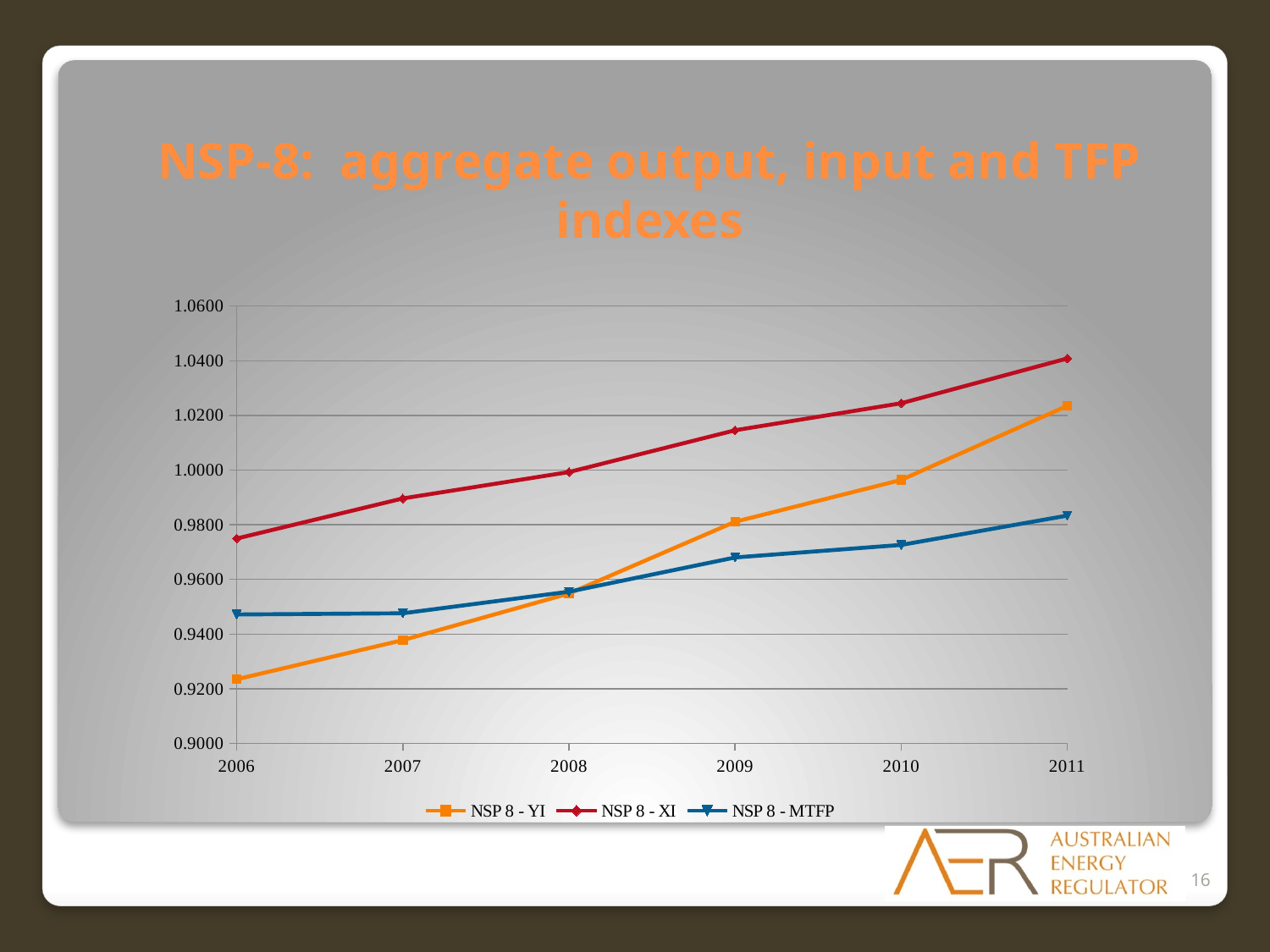
What kind of chart is shown on the slide? line chart Does NSP 8 - YI rise or fall from 2006 to 2011? rise Which series has the highest value in 2011? NSP 8 - XI In 2009, which is larger: NSP 8 - YI or NSP 8 - MTFP? NSP 8 - YI In which year is NSP 8 - XI at its lowest? 2006 How many years are plotted along the x axis? 6 Is the value for NSP 8 - XI in 2011 greater or less than 1.0200? greater Is the value for NSP 8 - YI in 2006 greater or less than 0.9400? less Is the value for NSP 8 - XI in 2006 greater or less than 0.9600? greater How many series does the legend list? 3 What is the title of the chart slide? NSP-8: aggregate output, input and TFP indexes